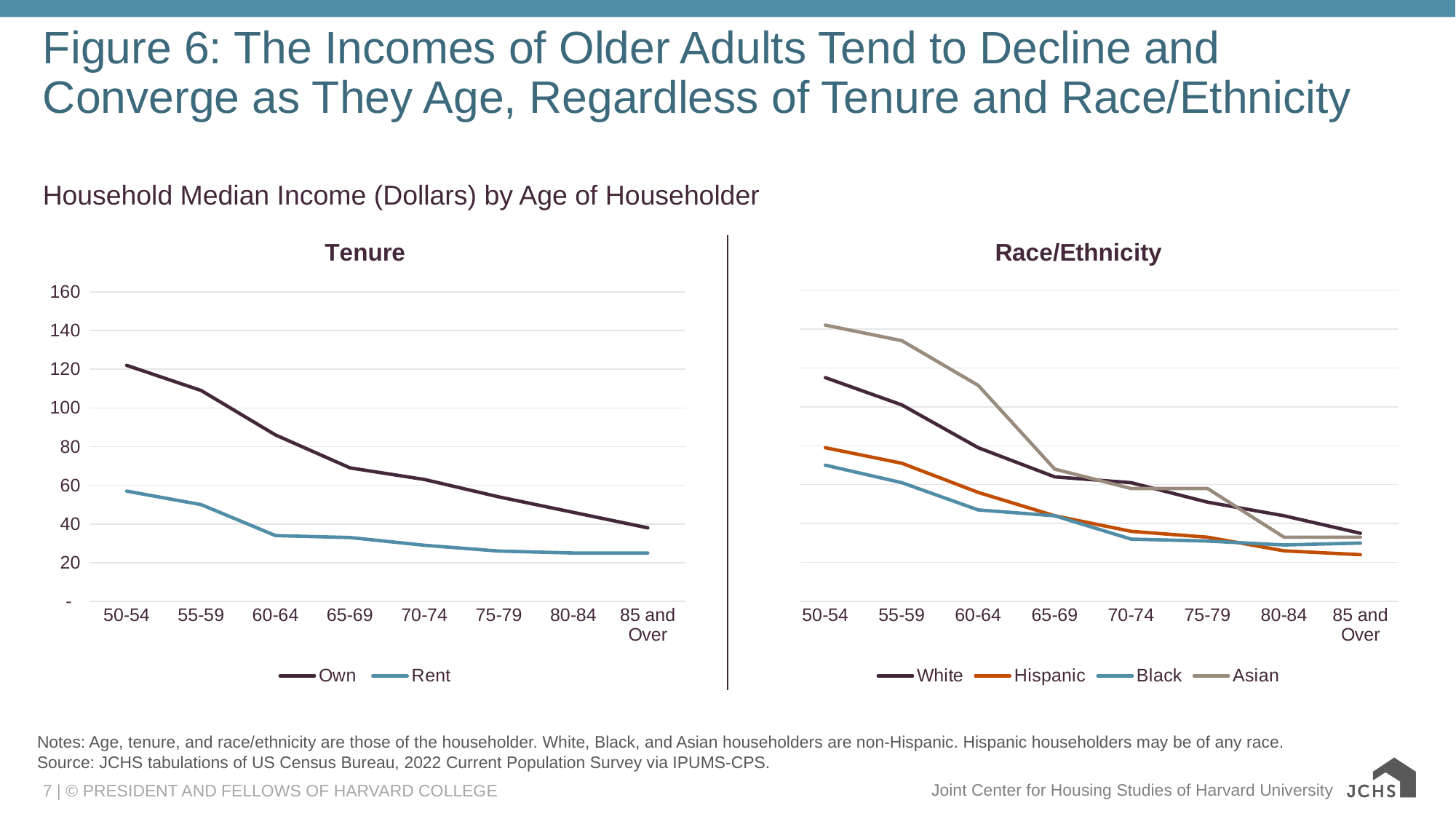
How many age groups are shown on the x axis of the Tenure chart? 8 In the Race/Ethnicity chart, is the value for Asian at 50-54 greater or less than 120? greater What is the title of the chart on the right side of the slide? Race/Ethnicity What kind of chart is the Tenure chart? line chart In the Race/Ethnicity chart, which series has the lowest value for the 50-54 age group? Black In the Tenure chart, is the value for Rent at 50-54 greater or less than 80? less In the Tenure chart, is the value for Own at 50-54 greater or less than 100? greater In the Tenure chart, do the values for Own rise or fall as age increases? fall How many series does the legend of the Race/Ethnicity chart list? 4 How many series does the legend of the Tenure chart list? 2 In the Race/Ethnicity chart, which series has the highest value for the 50-54 age group? Asian In the Race/Ethnicity chart, which is larger at 60-64, the value for White or the value for Hispanic? White